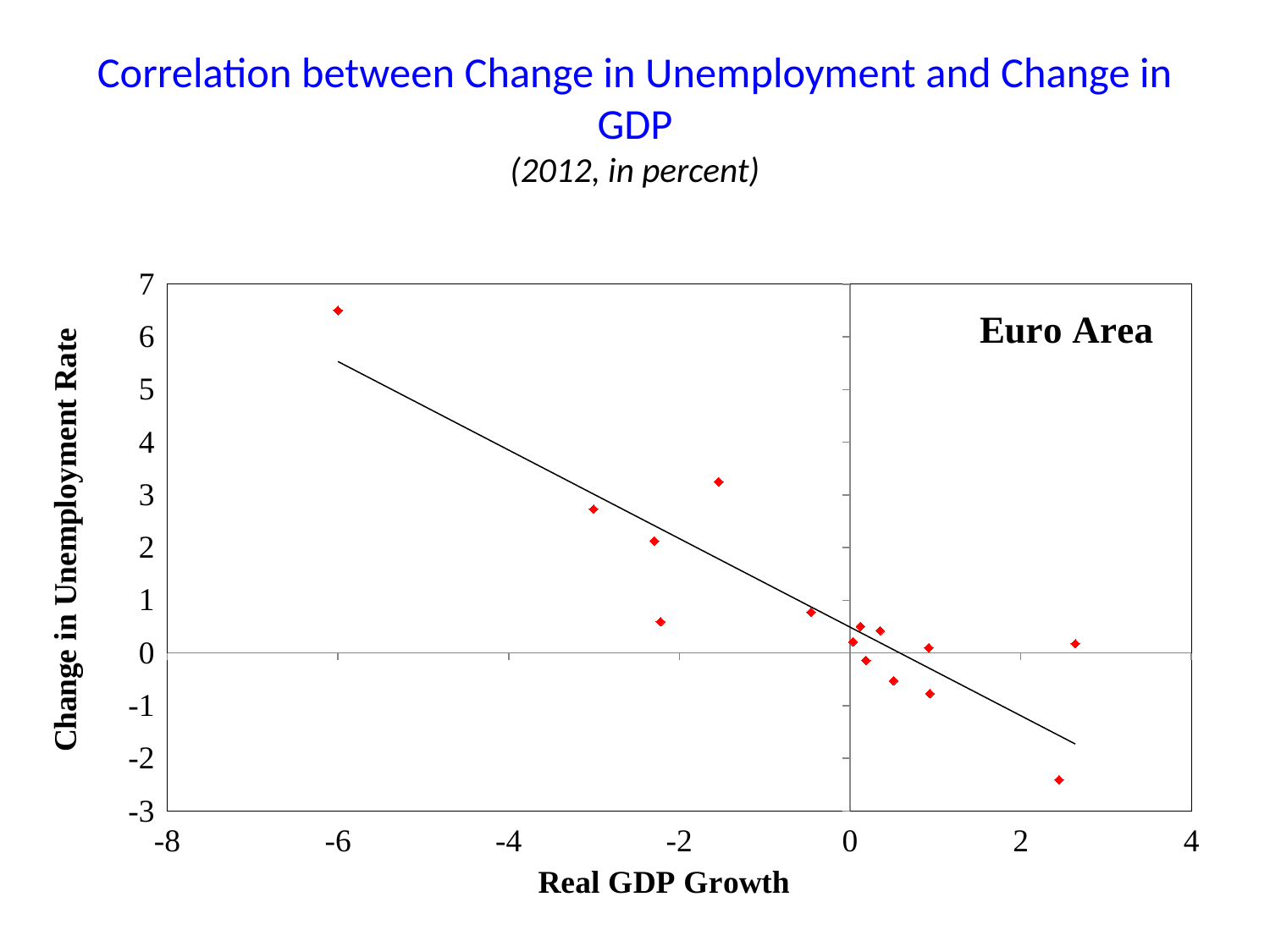
As Real GDP Growth increases along the x axis, does the Change in Unemployment Rate generally rise or fall? fall What is the title of the x axis? Real GDP Growth How many data points have a Real GDP Growth below -4? 1 How many data points are plotted in the chart? 15 Is the point with the highest Change in Unemployment Rate located at a positive or a negative Real GDP Growth? negative What label is printed inside the plot area in the upper right? Euro Area For the point with the lowest Change in Unemployment Rate, is that value greater or less than -2? less How many data points have a Change in Unemployment Rate above 2? 4 Does the fitted line in the chart slope upward or downward from left to right? downward For the point with the lowest Real GDP Growth, is its Change in Unemployment Rate greater or less than 6? greater For the point with the lowest Change in Unemployment Rate, is its Real GDP Growth greater or less than 2? greater What kind of chart is shown on the slide? scatter chart